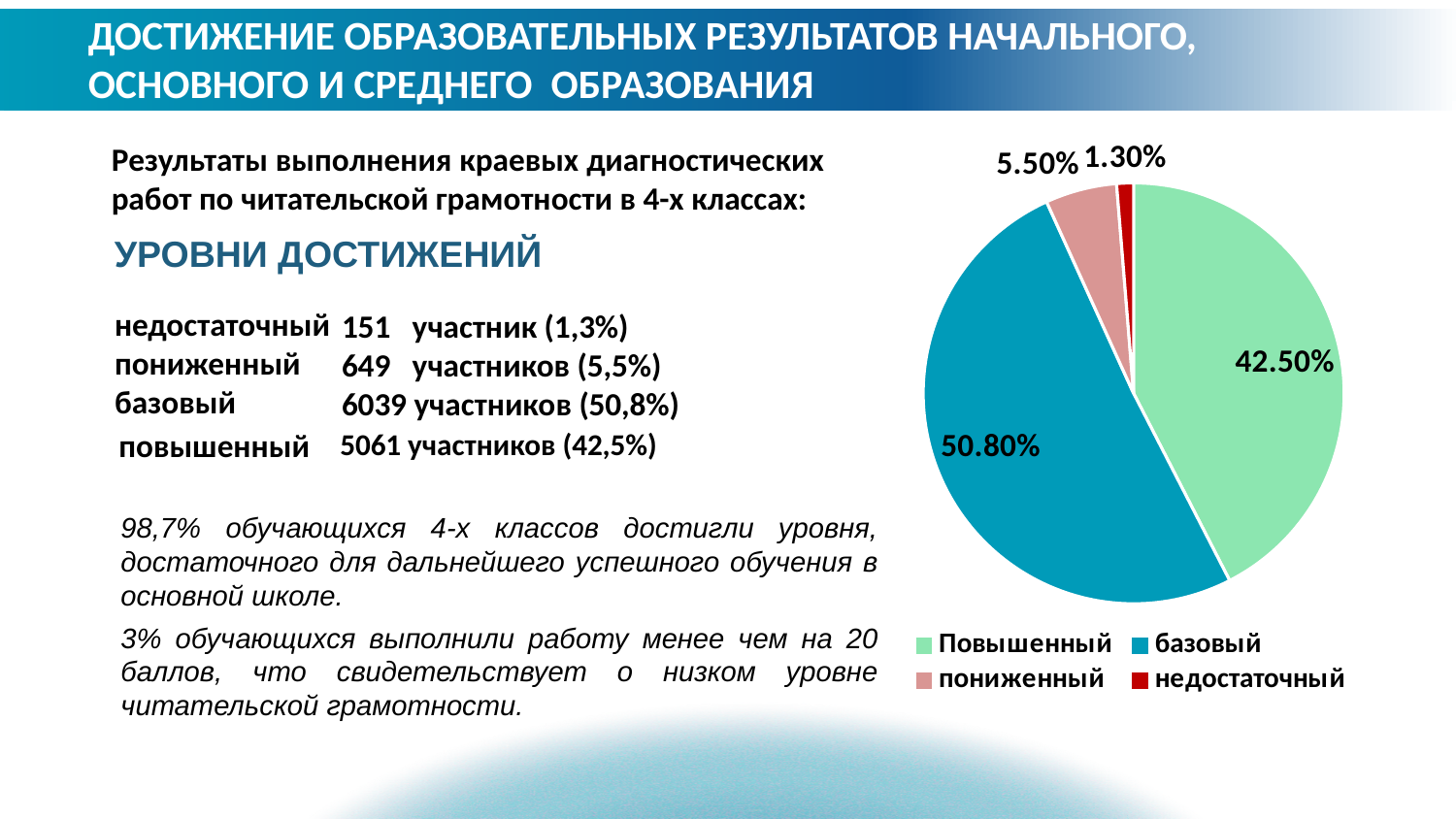
What is the difference in percentage points between the "базовый" and "Повышенный" slices? 8.30% What share of the pie does the "Повышенный" slice represent? 42.50% What share of the pie does the "пониженный" slice represent? 5.50% What colour is the "недостаточный" slice in the pie chart? dark red How many slices does the pie chart have? 4 Which slice of the pie chart is the smallest? недостаточный Which slice of the pie chart is the largest? базовый Which is larger, the "пониженный" slice or the "недостаточный" slice? пониженный How many entries does the legend of the pie chart list? 4 What type of chart is shown on the slide? pie chart What share of the pie does the "базовый" slice represent? 50.80% What share of the pie does the "недостаточный" slice represent? 1.30%